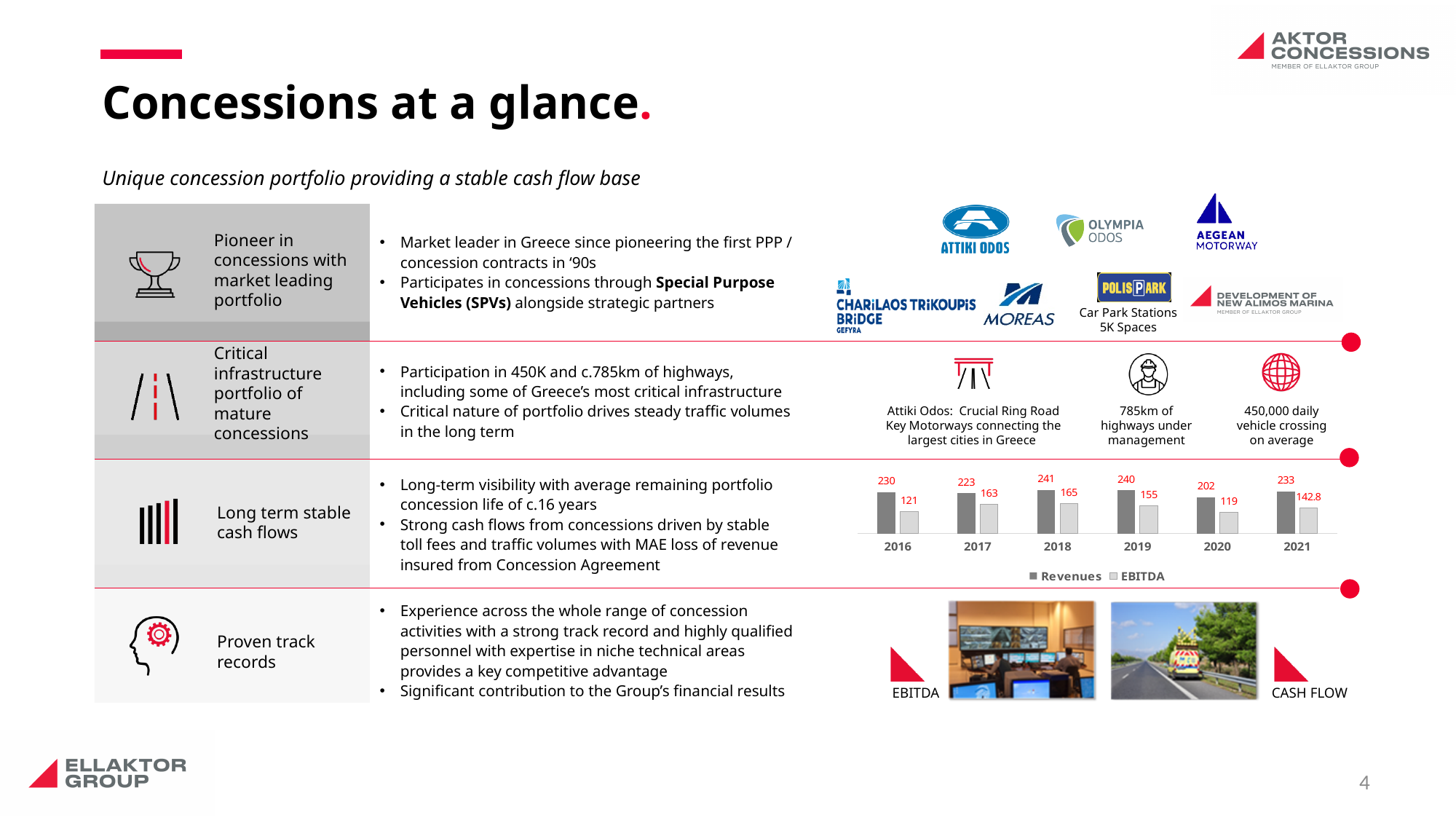
What is the EBITDA value for 2016? 121 What is the difference between Revenues and EBITDA in 2019? 85 Which year has the lowest EBITDA value? 2020 What is the EBITDA value for 2021? 142.8 What is the Revenues value for 2018? 241 Which is larger, the EBITDA value for 2017 or the EBITDA value for 2020? 2017 What type of chart is shown on the slide? bar chart How many years are shown on the x axis of the chart? 6 Which year has the highest Revenues value? 2018 How many series does the chart legend list? 2 Do the Revenues values rise or fall from 2019 to 2020? fall What are the two series named in the chart legend? Revenues and EBITDA